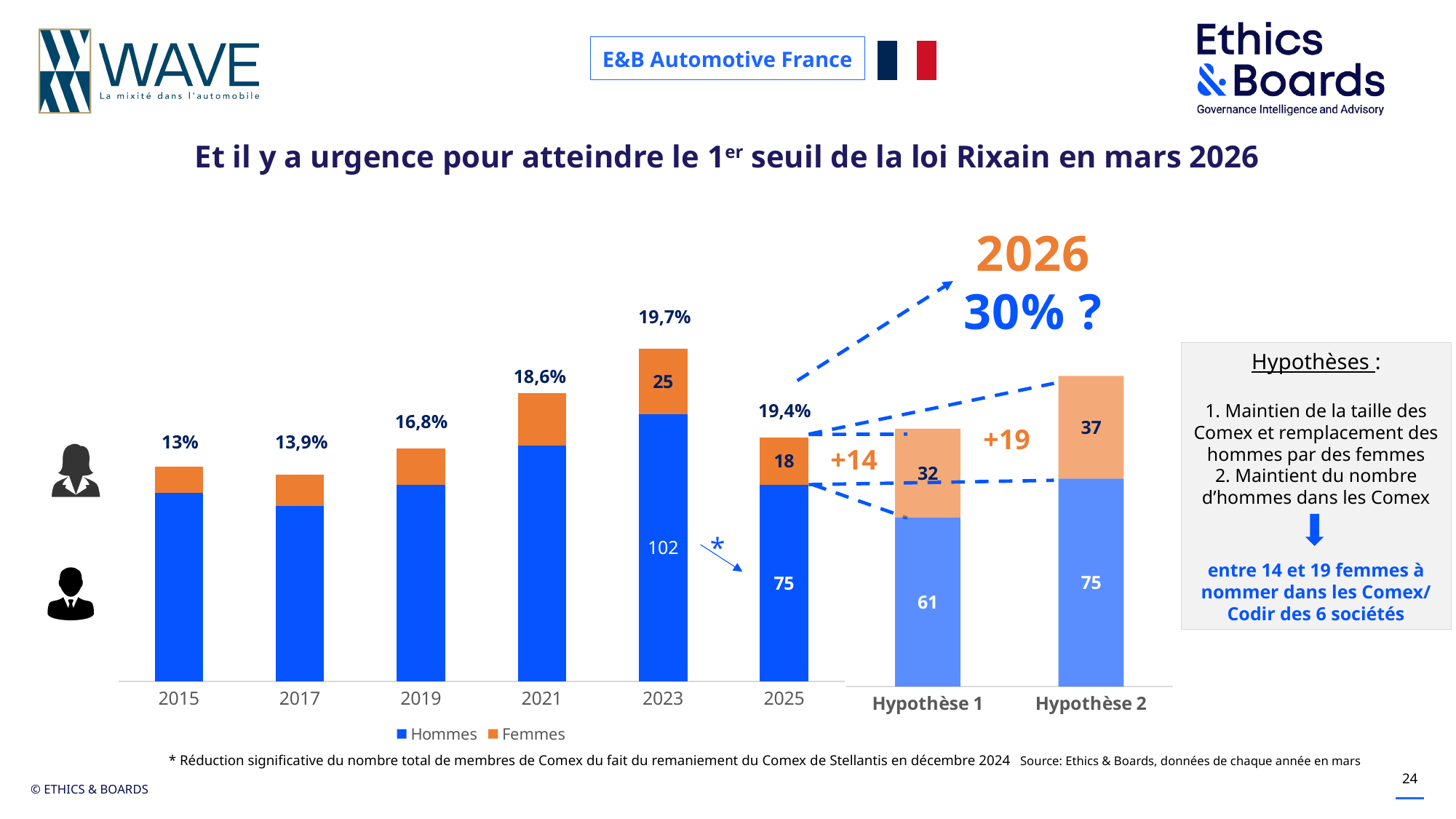
What is the Hommes value for Hypothèse 1? 61 What percentage is shown above the 2015 bar? 13% What kind of chart is shown on the slide? Stacked bar chart What percentage is shown above the 2025 bar? 19,4% What is the total of the stacked bar for 2025 (Hommes plus Femmes)? 93 Which year has the lowest percentage label above its bar? 2015 Is the Hommes value for 2023 larger or smaller than the Hommes value for 2025? larger How many series does the legend list? 2 What is the Femmes value for 2023? 25 What is the Femmes value for Hypothèse 2? 37 Which year has the highest percentage label above its bar? 2023 What is the difference between the Femmes values for Hypothèse 2 and Hypothèse 1? 5